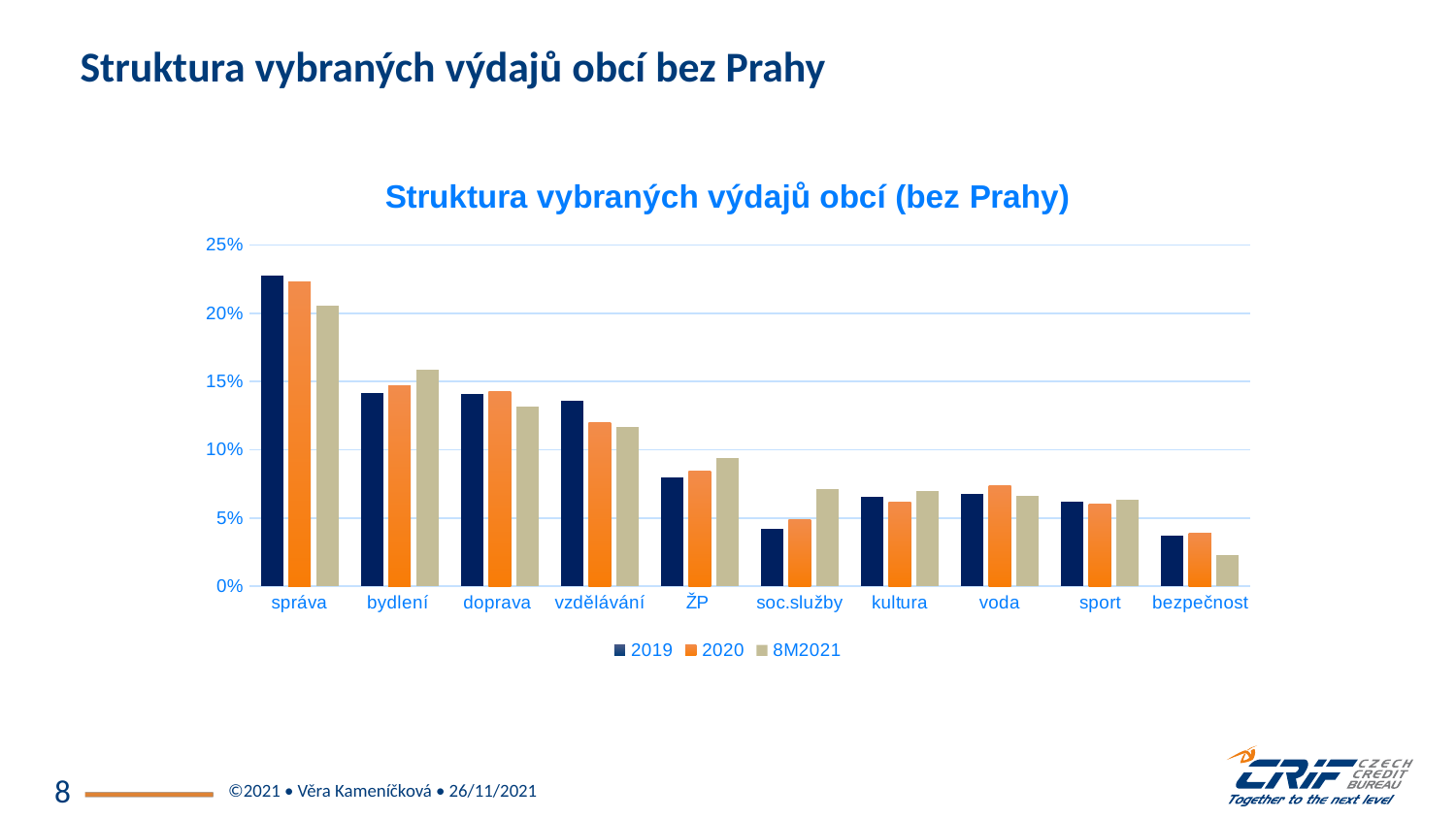
Which category has the highest value for 2019? správa How many series does the legend list? 3 Which category has the lowest value for 8M2021? bezpečnost Is the 8M2021 value for bezpečnost greater or less than 5%? less What are the three series listed in the legend? 2019, 2020, 8M2021 What kind of chart is shown on the slide? bar chart Is the 2019 value for ŽP greater or less than 10%? less For soc.služby, which series has the larger value: 2019 or 8M2021? 8M2021 For bydlení, which series has the larger value: 2019 or 8M2021? 8M2021 Is the 2019 value for správa greater or less than 20%? greater How many expenditure categories are shown on the x axis? 10 What is the title of the chart? Struktura vybraných výdajů obcí (bez Prahy)